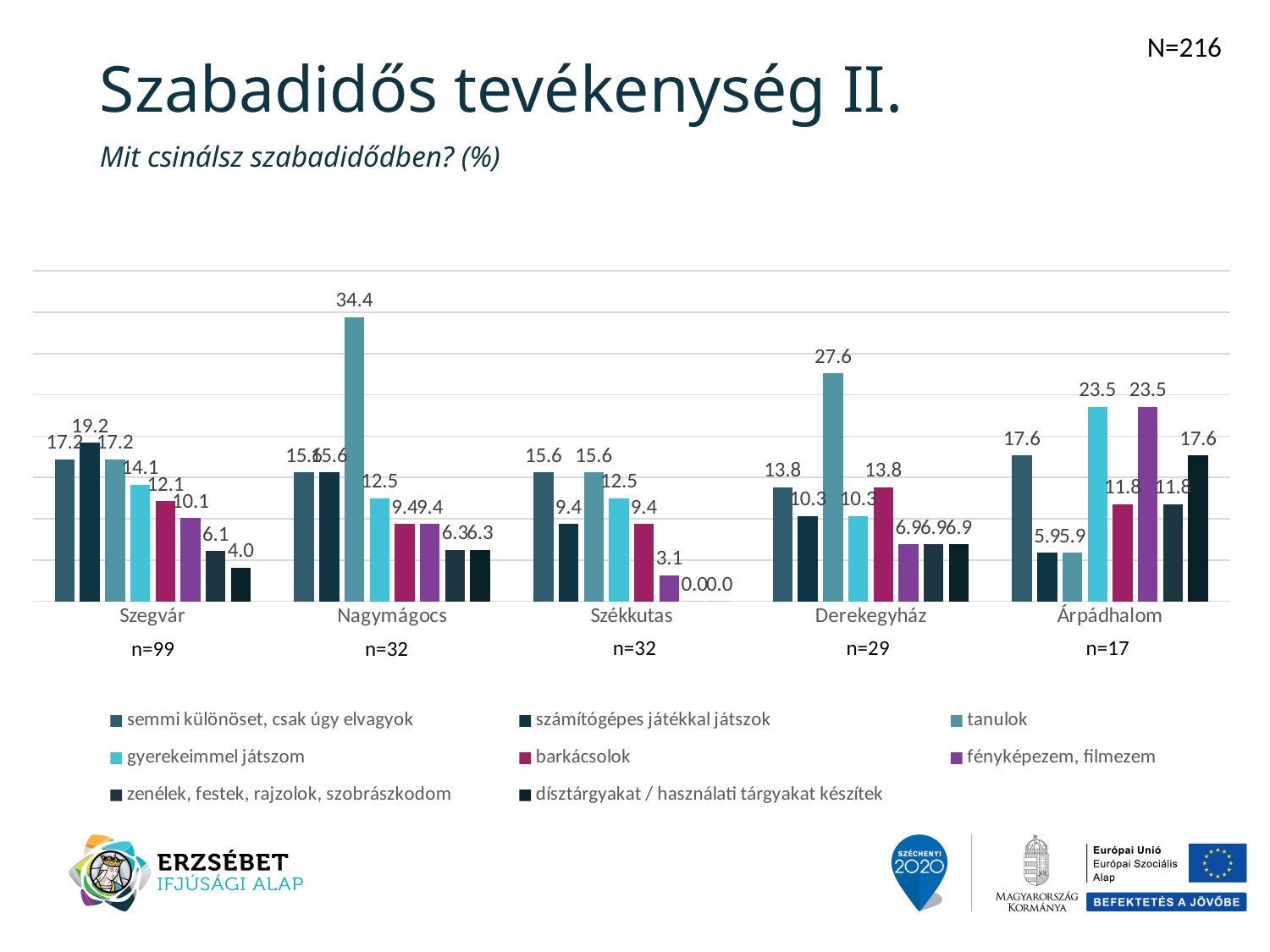
What is the value for "számítógépes játékkal játszok" in Szegvár? 19.2 Which has the larger value for "gyerekeimmel játszom": Árpádhalom or Szegvár? Árpádhalom How many series does the legend list? 8 What is the value for "tanulok" in Derekegyház? 27.6 What is the difference between the "tanulok" value in Nagymágocs and the "tanulok" value in Derekegyház? 6.8 Which series has the highest value in Nagymágocs? tanulok Which series has the lowest value in Szegvár? dísztárgyakat / használati tárgyakat készítek How many settlements (categories) are shown on the x axis? 5 What is the value for "zenélek, festek, rajzolok, szobrászkodom" in Székkutas? 0.0 What kind of chart is shown on the slide? bar chart What is the value for "tanulok" in Nagymágocs? 34.4 What is the sample size (n) shown for Szegvár? n=99